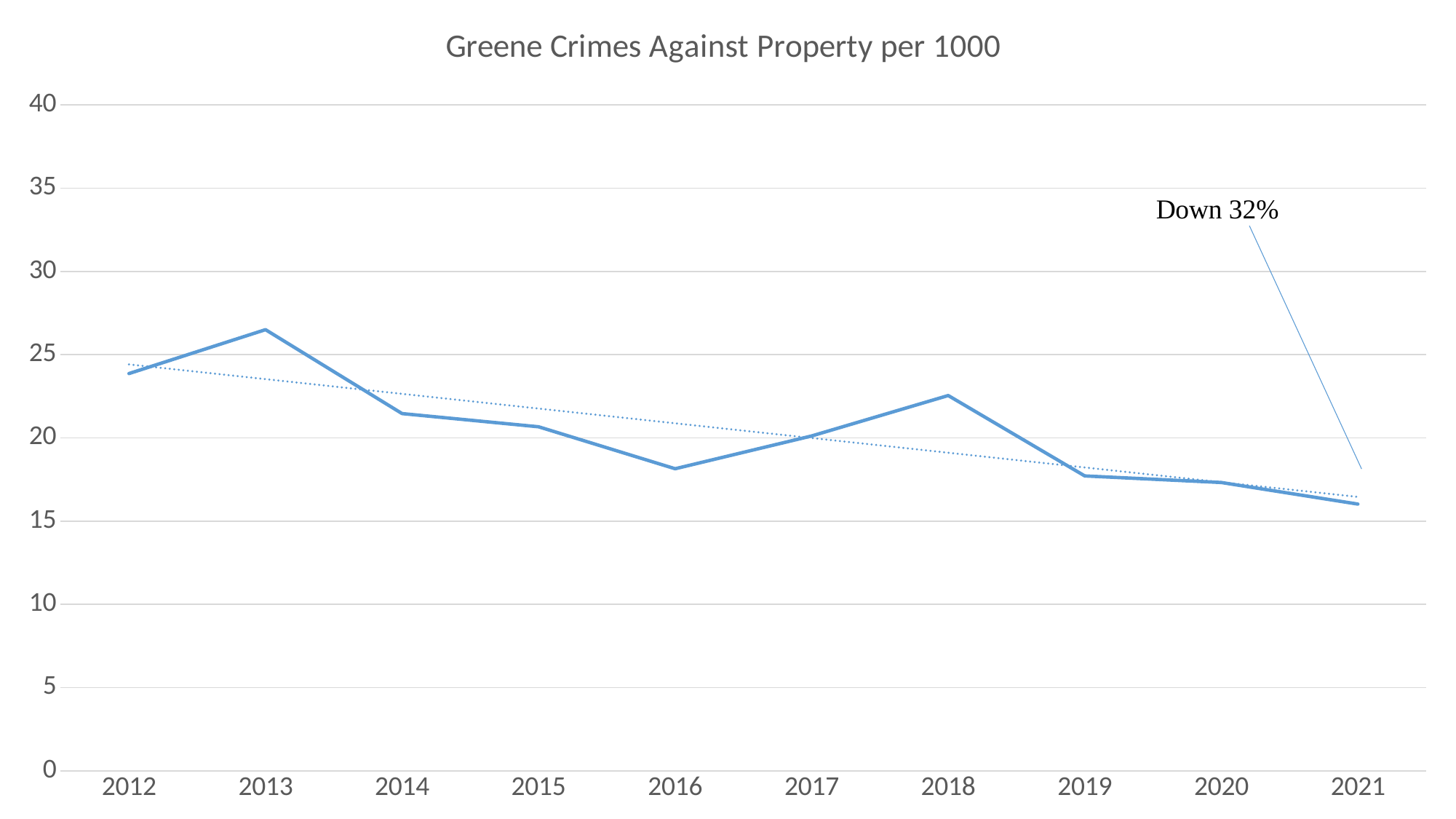
Do the values generally rise or fall from 2012 to 2021? fall Is the value for 2021 greater or less than 15? greater Which year has the highest value? 2013 Is the value for 2018 greater or less than 20? greater Which year has the lowest value? 2021 What is the title of the chart? Greene Crimes Against Property per 1000 Is the value for 2016 greater or less than 20? less What does the annotation on the chart say? Down 32% How many years are plotted along the x axis? 10 What kind of chart is shown on the slide? line chart Which year has the larger value, 2013 or 2018? 2013